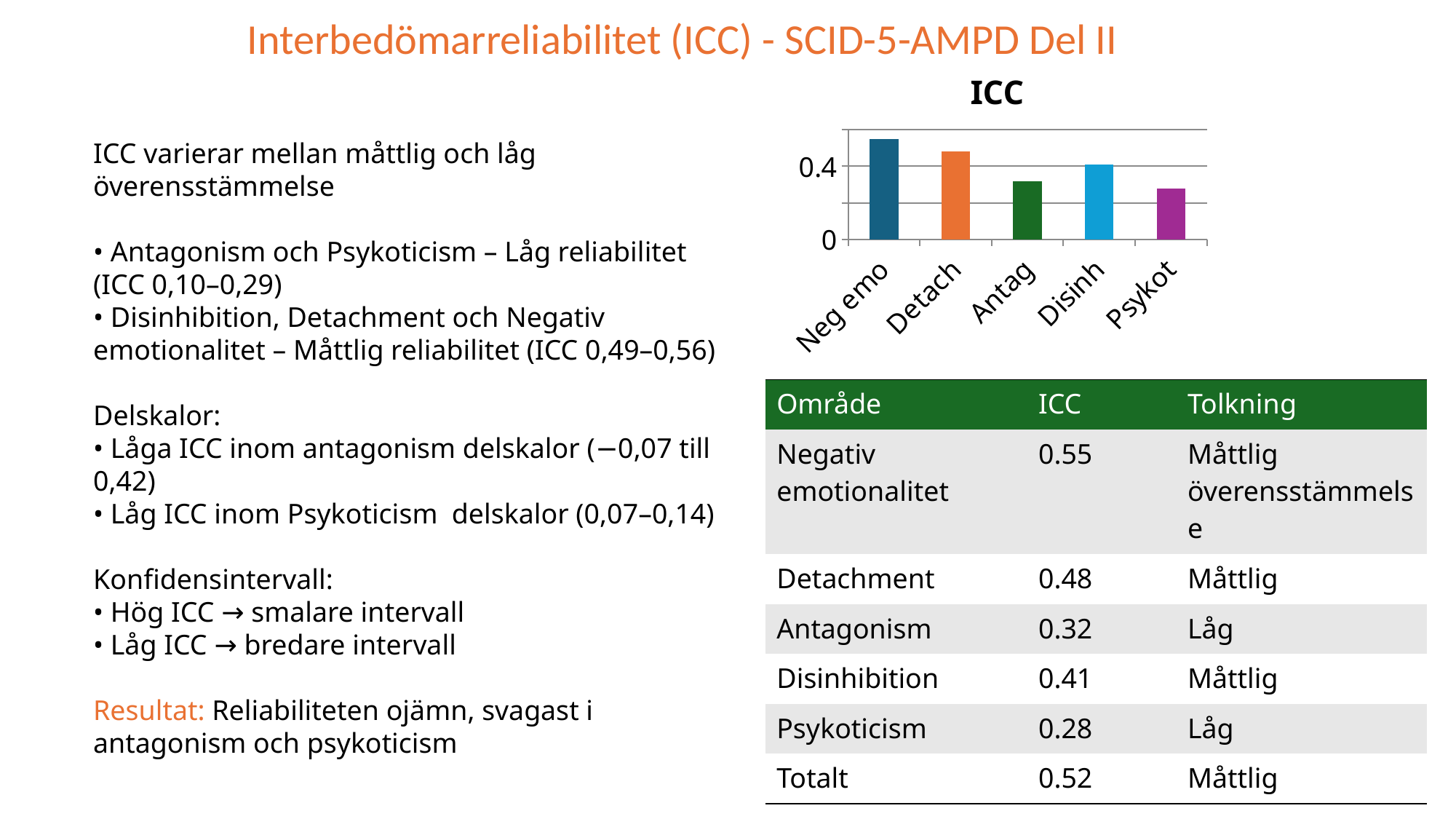
Is the value for Neg emo greater or less than 0.4? greater Is the value for Antag greater or less than 0.4? less Is the value for Detach greater or less than 0.4? greater Which is larger, the bar for Neg emo or the bar for Antag? Neg emo What is the title of the chart? ICC Which category has the lowest bar in the chart? Psykot Which is larger, the bar for Detach or the bar for Psykot? Detach What kind of chart is shown on the slide? bar chart Which category has the highest bar in the chart? Neg emo How many categories are shown on the x axis of the chart? 5 What colour is the bar for Detach? orange